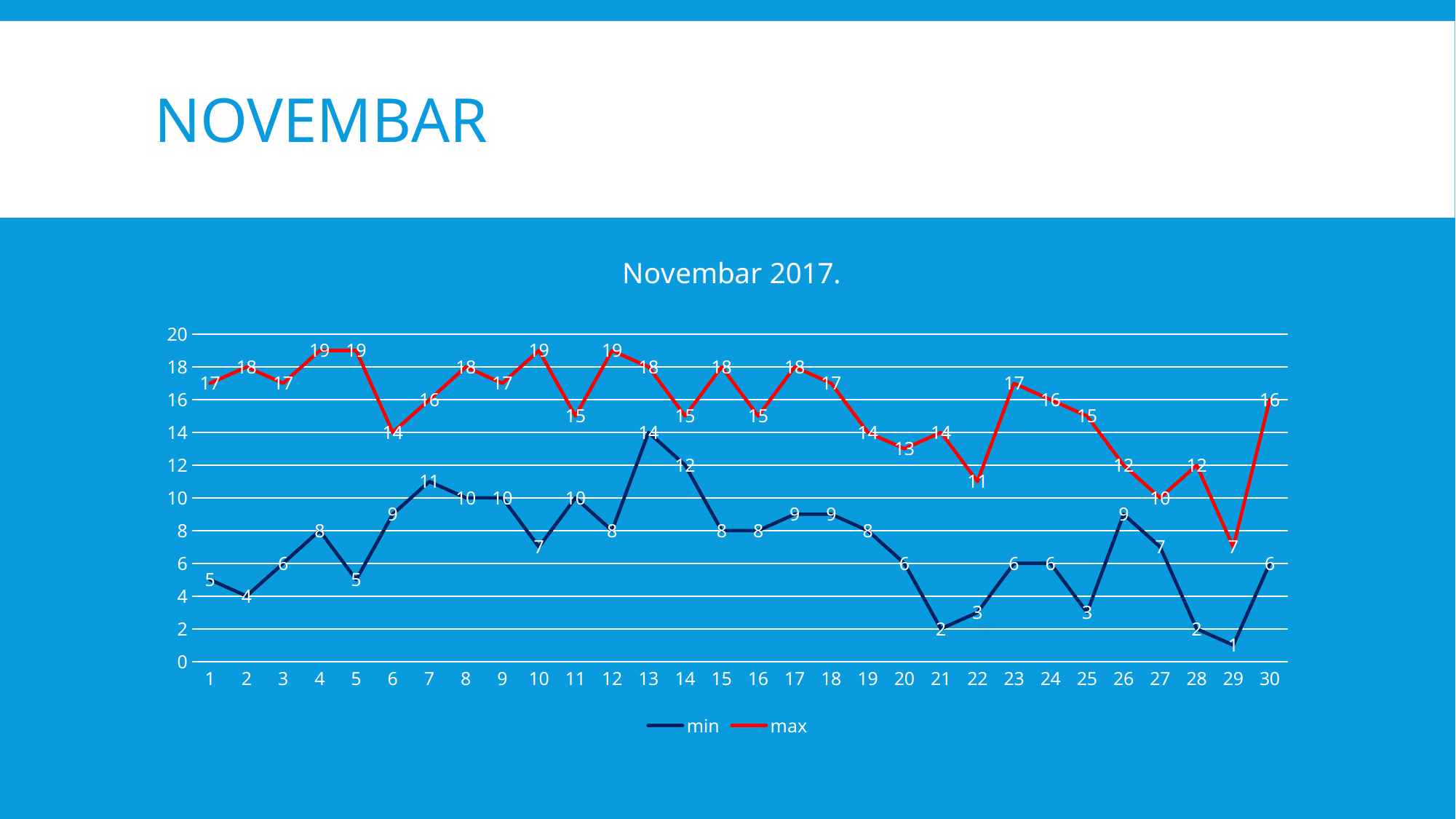
What is the difference between the max and min values on day 13? 4 On which day is the min series at its lowest? 29 What is the difference between the max values on day 5 and day 6? 5 What is the max value on day 13? 18 What is the min value on day 7? 11 On which day is the max series at its lowest? 29 On which day is the min series at its highest? 13 What type of chart is shown on the slide? line chart Which is larger, the min value on day 26 or the min value on day 27? day 26 What is the max value on day 29? 7 How many days are plotted on the x axis? 30 How many series does the legend list? 2